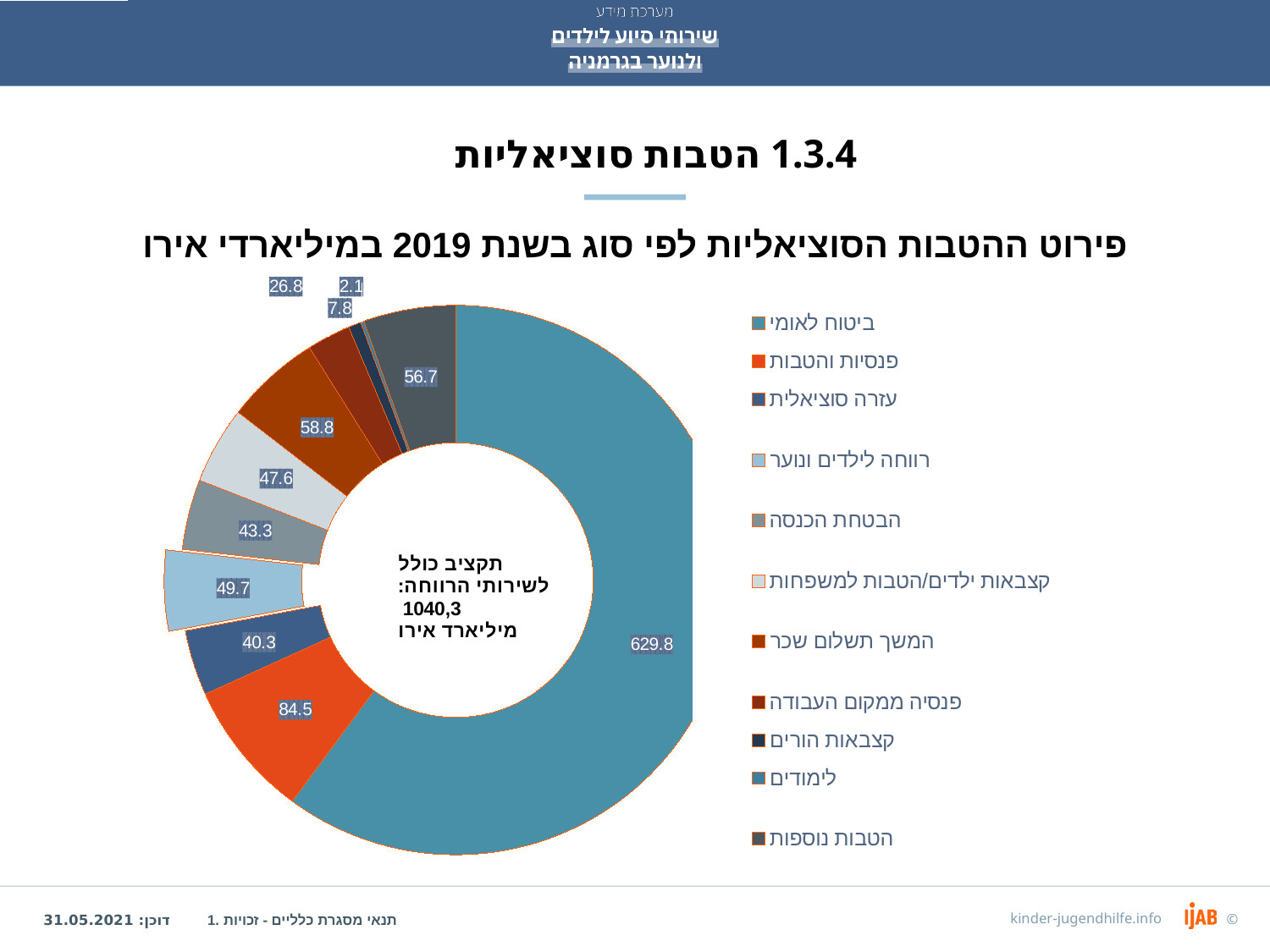
What is the value shown on the exploded light-blue slice (רווחה לילדים ונוער)? 49.7 Which is larger: the slice labelled 58.8 or the slice labelled 56.7? 58.8 What is the value of the smallest slice in the chart? 2.1 What is the value of the largest slice in the chart? 629.8 Which legend category corresponds to the largest slice of the chart? ביטוח לאומי What is the value shown for פנסיות והטבות (the orange slice)? 84.5 What type of chart is shown on the slide? Doughnut (pie) chart What total budget is stated in the centre of the doughnut chart? 1040,3 מיליארד אירו For which year does the chart show the breakdown of social benefits? 2019 How many categories are listed in the legend? 11 How many slices does the chart contain? 11 What is the difference between the largest slice (629.8) and the second-largest slice (84.5)? 545.3